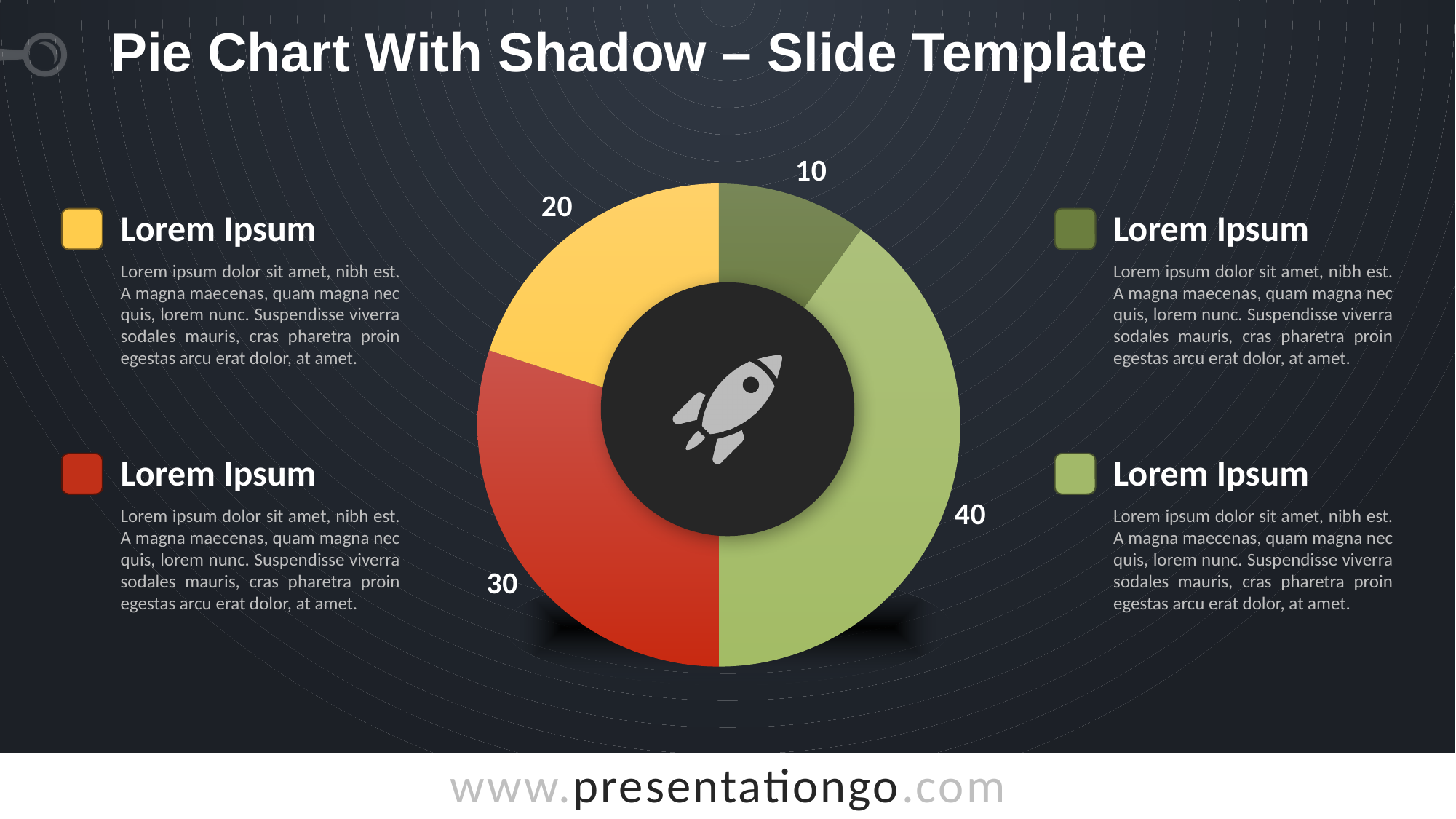
What is the value of the red slice? 30 How many slices does the pie chart have? 4 Which slice has the smallest value? Dark green (10) Which slice has the largest value? Light green (40) What share of the total does the light green slice represent? 40% What kind of chart is shown on the slide? Pie chart Which is larger, the yellow slice or the red slice? Red slice What is the value of the light green slice? 40 What is the total of all the slice values? 100 What is the value of the yellow slice? 20 What is the value of the dark green slice? 10 What is the difference between the light green slice and the red slice? 10